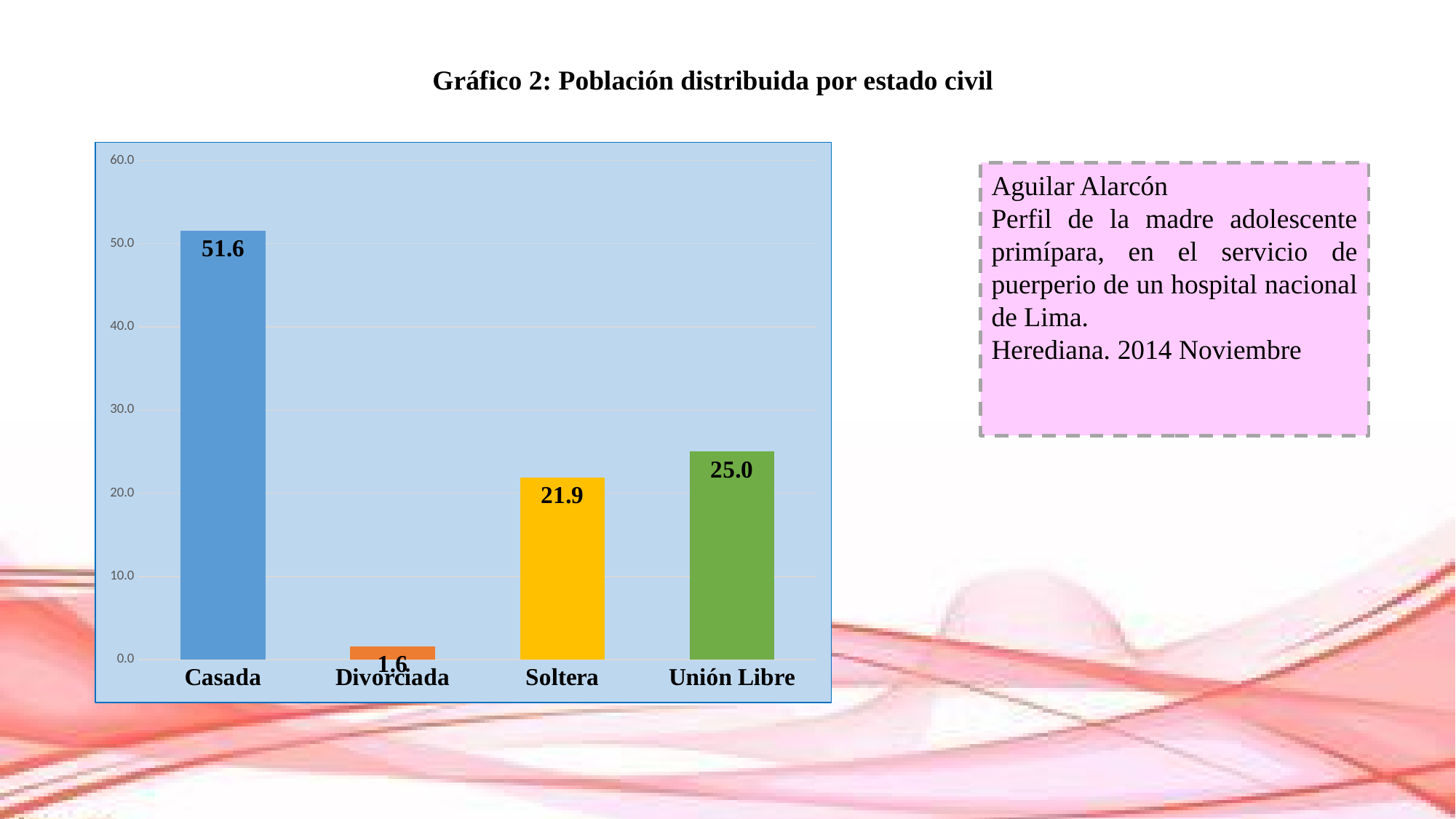
What is the title of the chart? Gráfico 2: Población distribuida por estado civil What is the value for Unión Libre? 25.0 Which is larger, the value for Soltera or the value for Unión Libre? Unión Libre Which category has the lowest value? Divorciada How many categories are shown on the x axis? 4 What is the difference between the values for Unión Libre and Soltera? 3.1 What is the value for Casada? 51.6 What is the value for Divorciada? 1.6 What is the difference between the values for Casada and Unión Libre? 26.6 What kind of chart is shown on the slide? Bar chart What is the value for Soltera? 21.9 Which category has the highest value? Casada